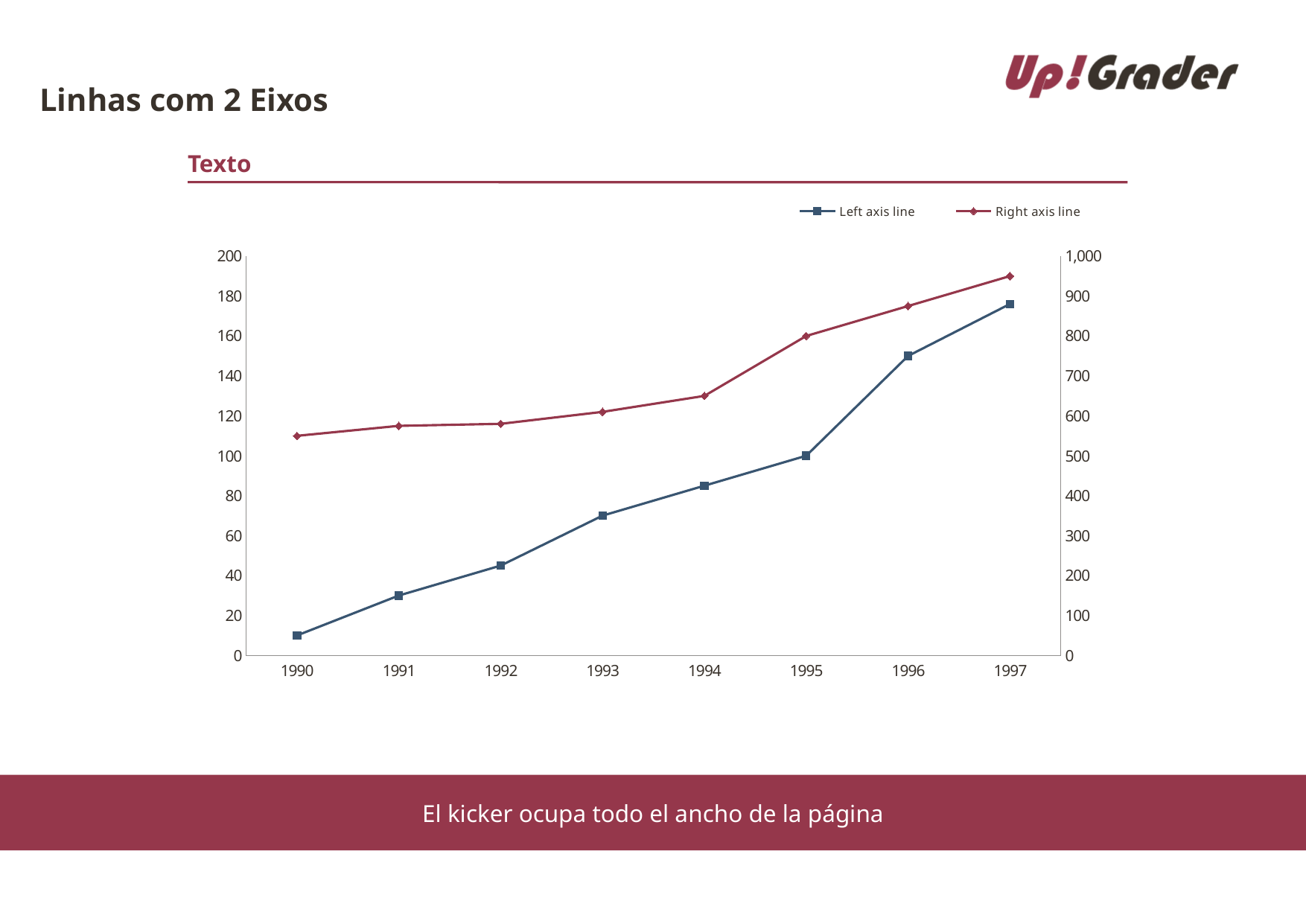
Is the value of the Right axis line in 1990 greater or less than 600? less How many years are plotted along the x axis? 8 In which year is the Left axis line at its highest? 1997 How many series does the legend list? 2 Do the values of the Left axis line rise or fall from 1990 to 1997? rise In which year is the Left axis line at its lowest? 1990 Is the value of the Left axis line in 1996 greater or less than 140? greater What is the maximum value shown on the right-hand vertical axis? 1,000 Which is larger for the Left axis line: the value in 1992 or the value in 1994? 1994 Is the value of the Left axis line in 1993 greater or less than 80? less What are the two series names shown in the legend? Left axis line and Right axis line What kind of chart is shown on the slide? line chart